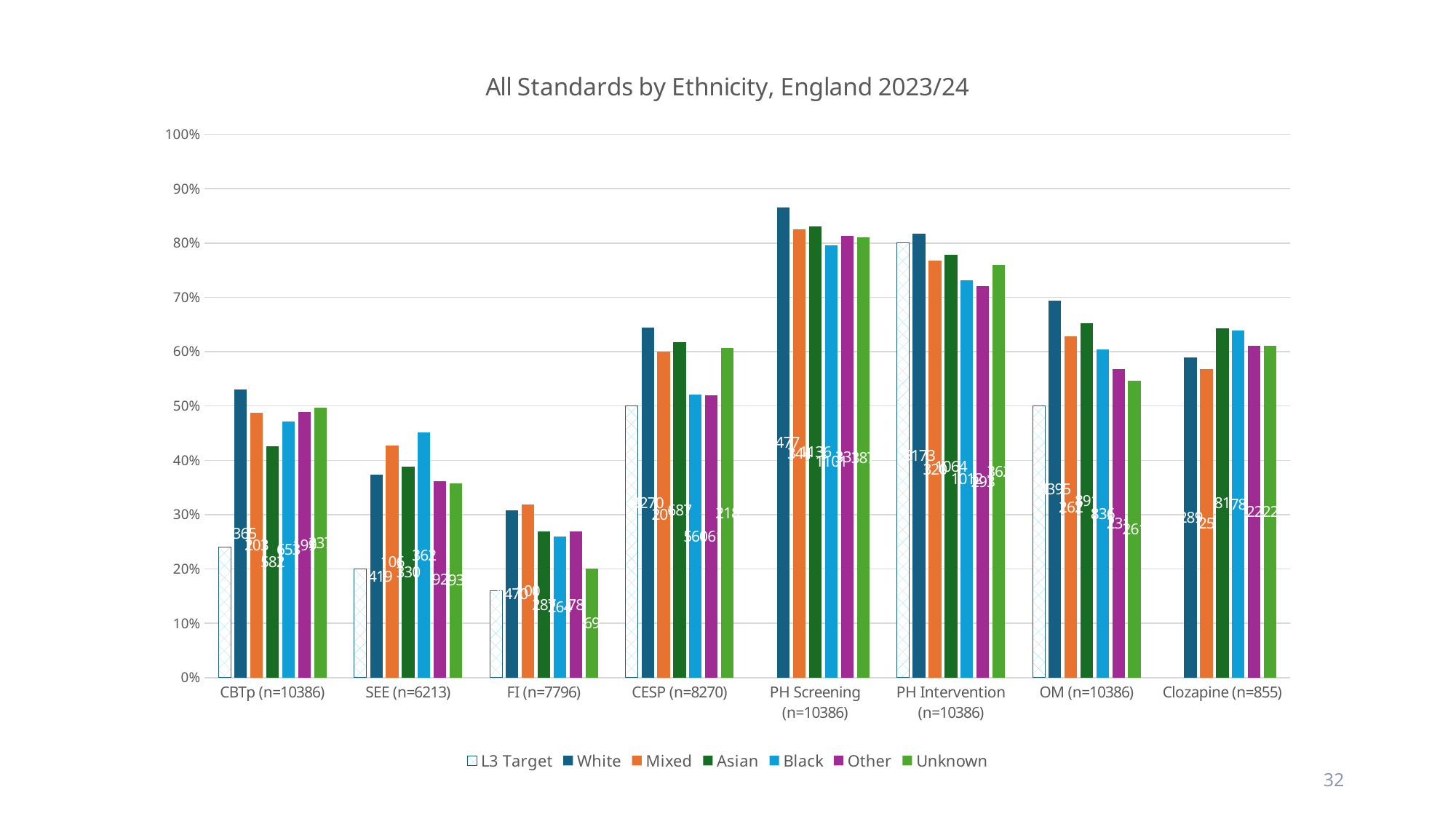
What is the title of the chart? All Standards by Ethnicity, England 2023/24 How many standards (categories) are shown along the x axis? 8 Which is larger: the White bar for CBTp (n=10386) or the White bar for SEE (n=6213)? CBTp (n=10386) Which series has the highest bar for CBTp (n=10386)? White Which series has the highest bar for SEE (n=6213)? Black How many series does the legend list? 7 What kind of chart is shown on the slide? Bar chart Is the Unknown bar for FI (n=7796) greater or less than 30%? less Is the White bar for PH Screening (n=10386) greater or less than 80%? greater Which series has the highest bar for PH Screening (n=10386)? White Is the Black bar for PH Intervention (n=10386) greater or less than 80%? less Which two categories have no L3 Target bar? PH Screening (n=10386) and Clozapine (n=855)